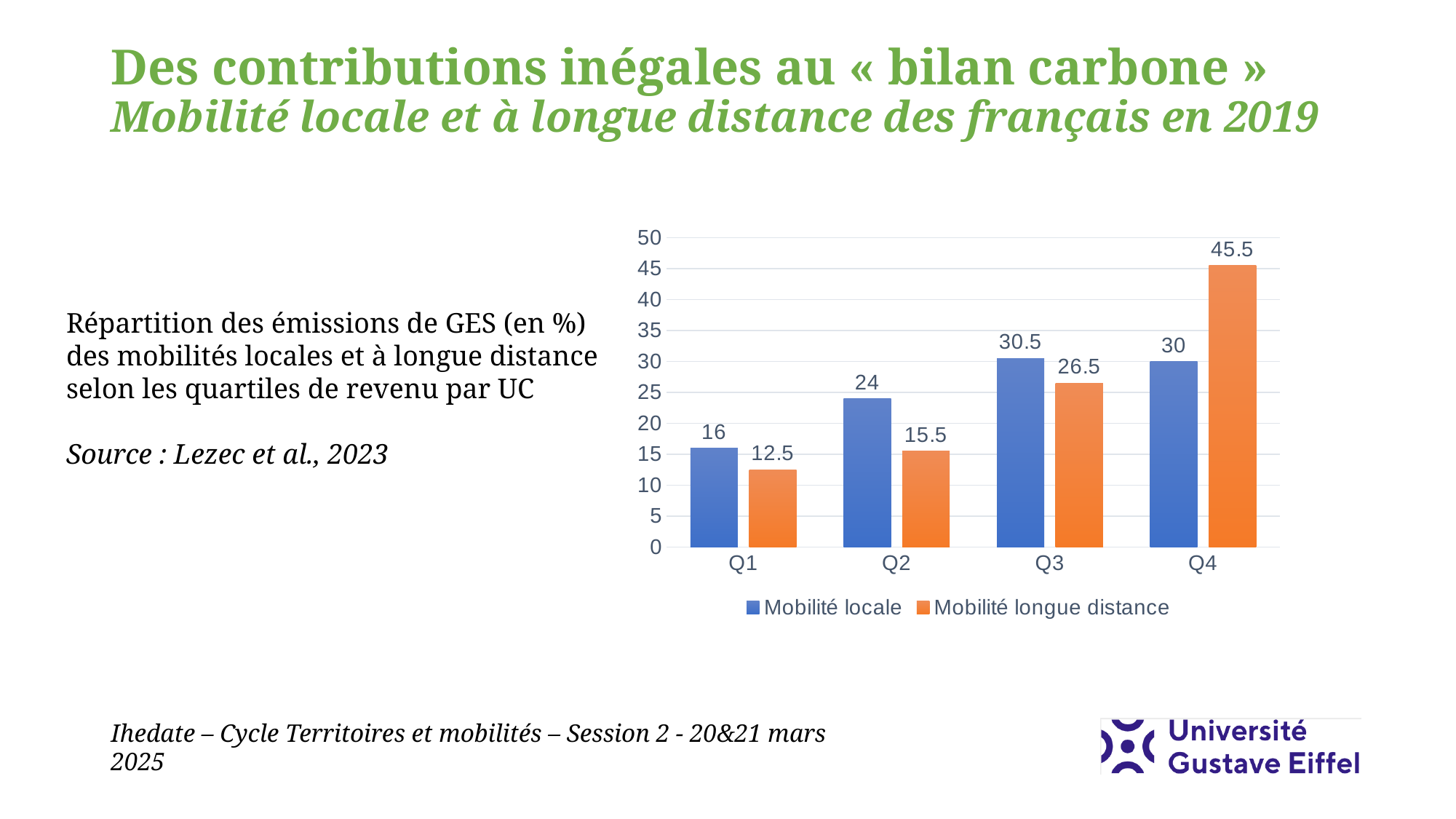
Which quartile has the highest value for Mobilité longue distance? Q4 How many quartile categories are shown on the x axis? 4 What is the value for Mobilité locale at Q1? 16 What is the value for Mobilité longue distance at Q4? 45.5 Which is larger at Q2: Mobilité locale or Mobilité longue distance? Mobilité locale Which quartile has the lowest value for Mobilité locale? Q1 Does the value for Mobilité longue distance rise or fall from Q1 to Q4? Rise How many series does the legend list? 2 What is the difference between Mobilité longue distance and Mobilité locale at Q4? 15.5 What is the value for Mobilité locale at Q3? 30.5 What kind of chart is shown on the slide? Bar chart What is the value for Mobilité longue distance at Q2? 15.5